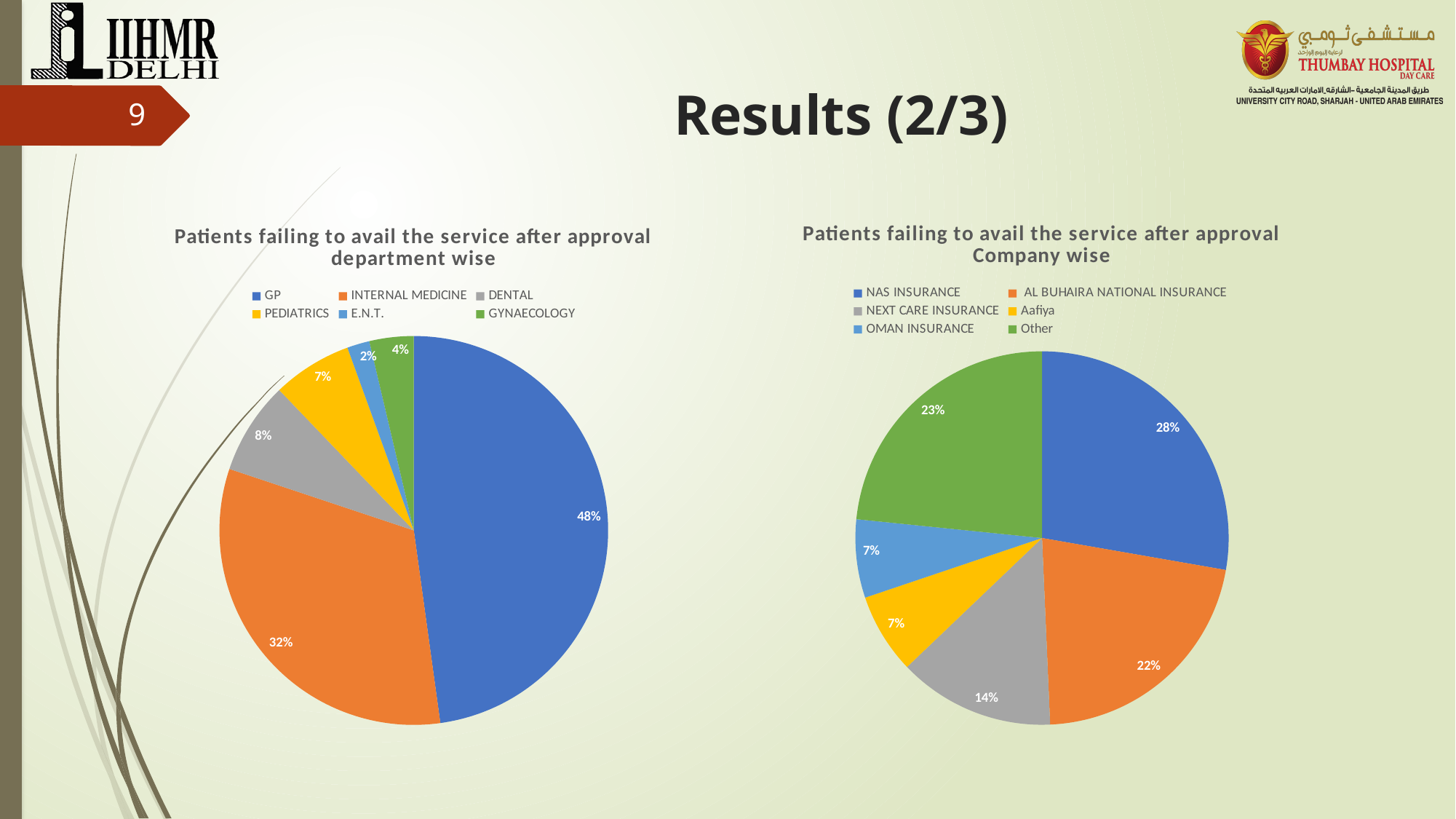
In the 'department wise' chart on the left, how many departments are shown in the legend? 6 In the 'Company wise' chart on the right, what is the difference between AL BUHAIRA NATIONAL INSURANCE and NEXT CARE INSURANCE? 8% In the 'Company wise' chart on the right, which company has the largest slice? NAS INSURANCE In the 'Company wise' chart on the right, what percentage is shown for Aafiya? 7% In the 'Company wise' chart on the right, which is larger: the 'Other' slice or the AL BUHAIRA NATIONAL INSURANCE slice? Other In the 'department wise' chart on the left, which department has the smallest slice? E.N.T. In the 'department wise' chart on the left, what is the difference between the DENTAL and PEDIATRICS percentages? 1% In the 'department wise' chart on the left, what share of patients failing to avail the service is GP? 48% In the 'Company wise' chart on the right, what percentage is shown for NAS INSURANCE? 28% In the 'department wise' chart on the left, what percentage is shown for INTERNAL MEDICINE? 32% In the 'Company wise' chart on the right, what colour is the 'Other' slice? Green What type of chart is used for 'Patients failing to avail the service after approval department wise'? Pie chart